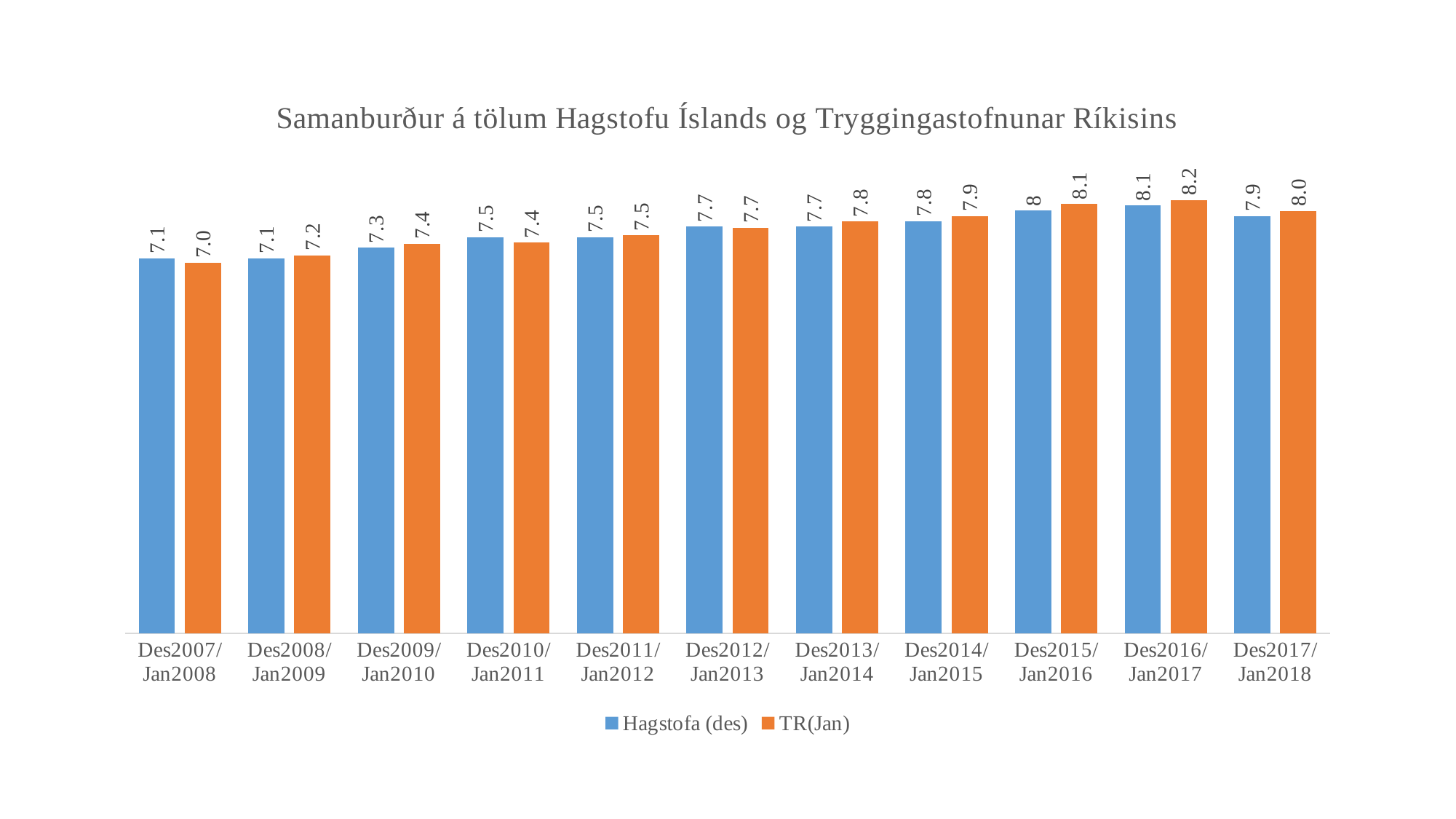
What is the title of the chart? Samanburður á tölum Hagstofu Íslands og Tryggingastofnunar Ríkisins What is the value for Hagstofa (des) at Des2015/Jan2016? 8 How many categories are shown on the x axis? 11 In which category is the TR(Jan) value highest? Des2016/Jan2017 What is the value for TR(Jan) at Des2014/Jan2015? 7.9 What type of chart is shown on the slide? Bar chart What is the value for Hagstofa (des) at Des2009/Jan2010? 7.3 Does the Hagstofa (des) value rise or fall from Des2016/Jan2017 to Des2017/Jan2018? Fall What is the difference between the TR(Jan) value at Des2016/Jan2017 and at Des2007/Jan2008? 1.2 Which is larger at Des2010/Jan2011: Hagstofa (des) or TR(Jan)? Hagstofa (des) How many series does the legend list? 2 In which category is the TR(Jan) value lowest? Des2007/Jan2008